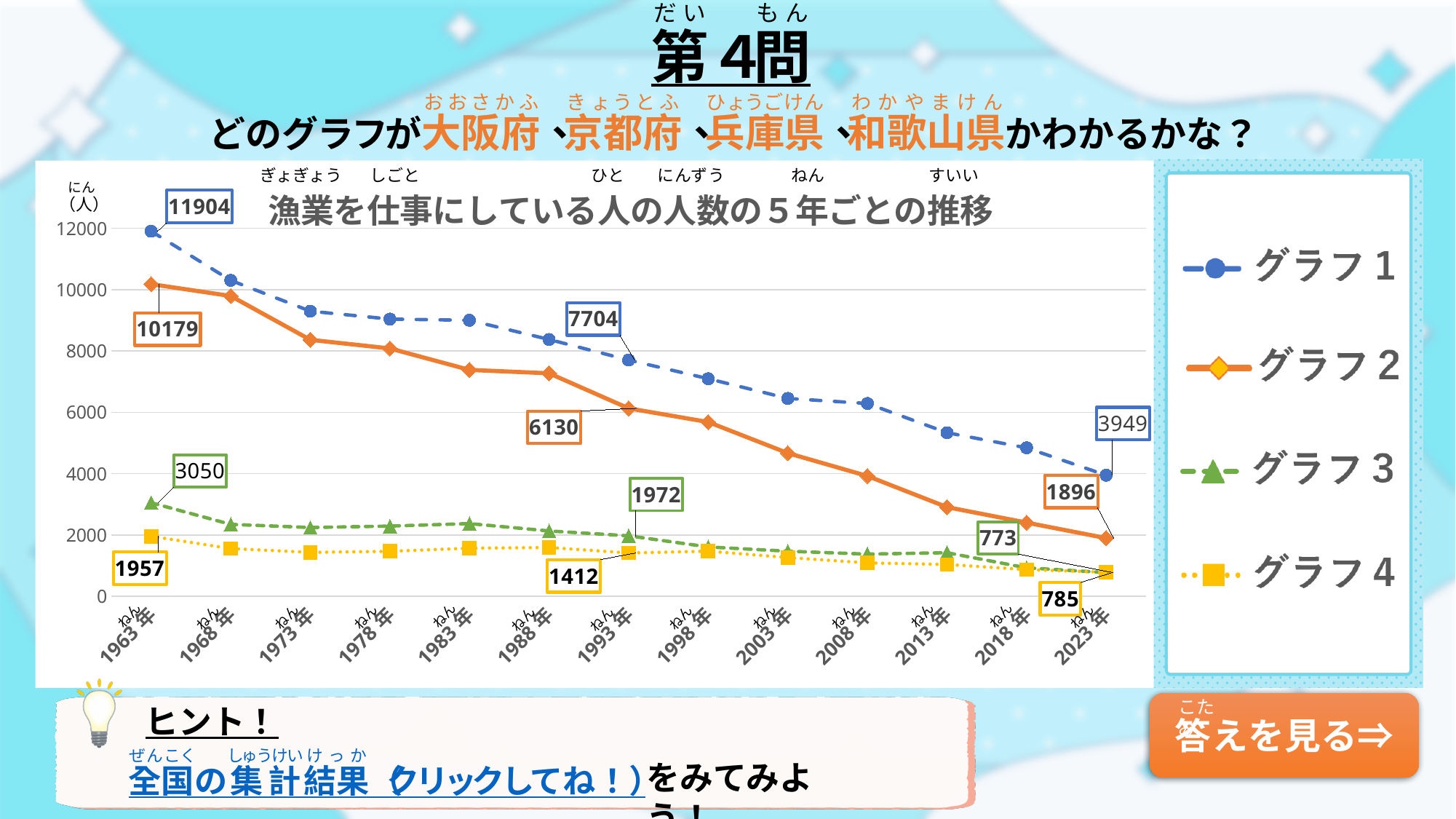
What is the value for グラフ2 in 1993年? 6130 What is the difference between グラフ1 and グラフ2 in 2023年? 2053 Do the values for グラフ2 rise or fall from 1963年 to 2023年? fall Is the value for グラフ1 in 2008年 greater or less than 6000? greater Which is larger in 1993年, グラフ3 or グラフ4? グラフ3 What is the value for グラフ3 in 2023年? 773 What is the value for グラフ4 in 1963年? 1957 How many years are shown on the x axis? 13 Which series has the highest value in 1963年? グラフ1 What type of chart is shown on the slide? line chart How many series does the legend list? 4 What is the value for グラフ1 in 1963年? 11904